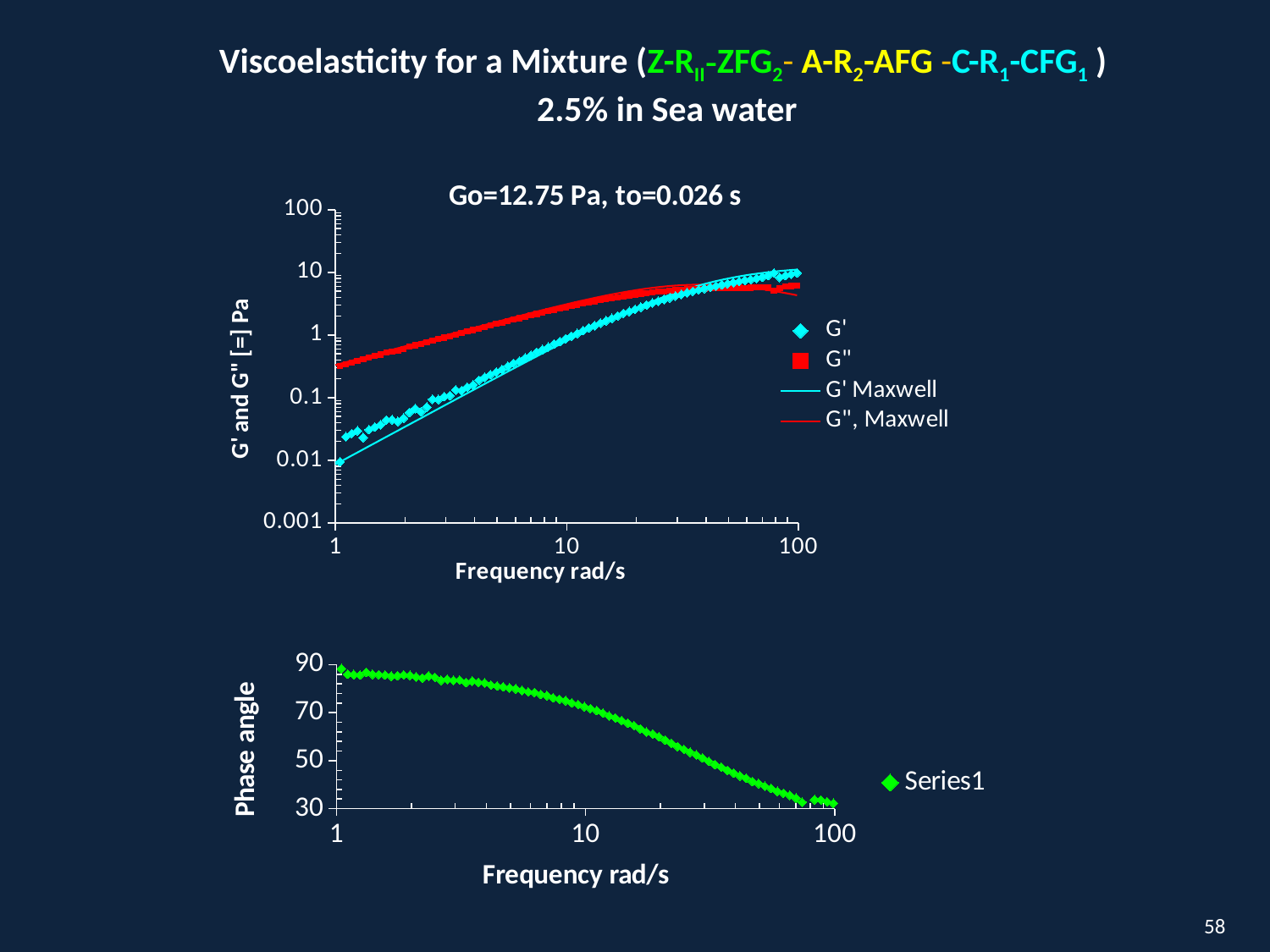
In the bottom chart, does the phase angle rise or fall as frequency increases? fall In the bottom chart, is the phase angle at a frequency of 1 rad/s greater or less than 70? greater In the bottom chart, is the phase angle at a frequency of 100 rad/s greater or less than 50? less In the top chart, is the value of G" at a frequency of 1 rad/s greater or less than 1? less In the top chart, at a frequency of 1 rad/s, which is larger, G' or G"? G" In the top chart, does G' rise or fall as frequency increases? rise In the top chart (Go=12.75 Pa, to=0.026 s), how many series does the legend list? 4 In the top chart, at a frequency of 100 rad/s, which is larger, G' or G"? G' In the top chart, what are the four legend entries? G', G", G' Maxwell, G", Maxwell In the bottom chart (Phase angle), how many series does the legend list? 1 In the top chart, what is the label of the y axis? G' and G" [=] Pa